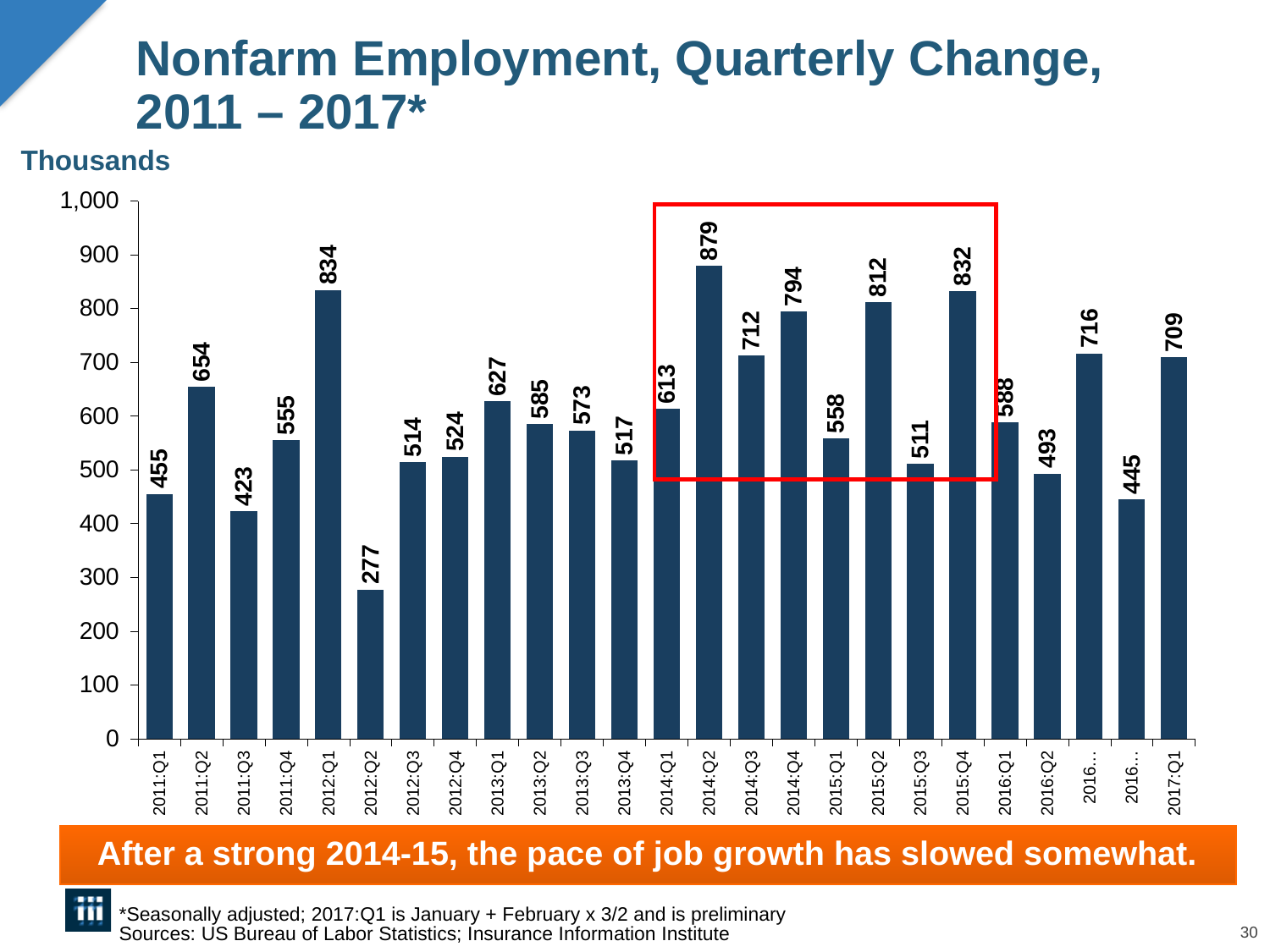
Which quarter has the highest value? 2014:Q2 What unit label is shown above the chart? Thousands Is the value for 2014:Q4 greater or less than 700? greater Which quarter has the lowest value? 2012:Q2 What is the difference between the values for 2015:Q4 and 2015:Q3? 321 What is the value for 2012:Q1? 834 What is the value for 2015:Q2? 812 What is the difference between the values for 2014:Q2 and 2012:Q2? 602 What kind of chart is shown on the slide? bar chart How many bars are plotted in the chart? 25 Which is larger, the value for 2011:Q2 or the value for 2013:Q1? 2011:Q2 What is the value for 2017:Q1? 709